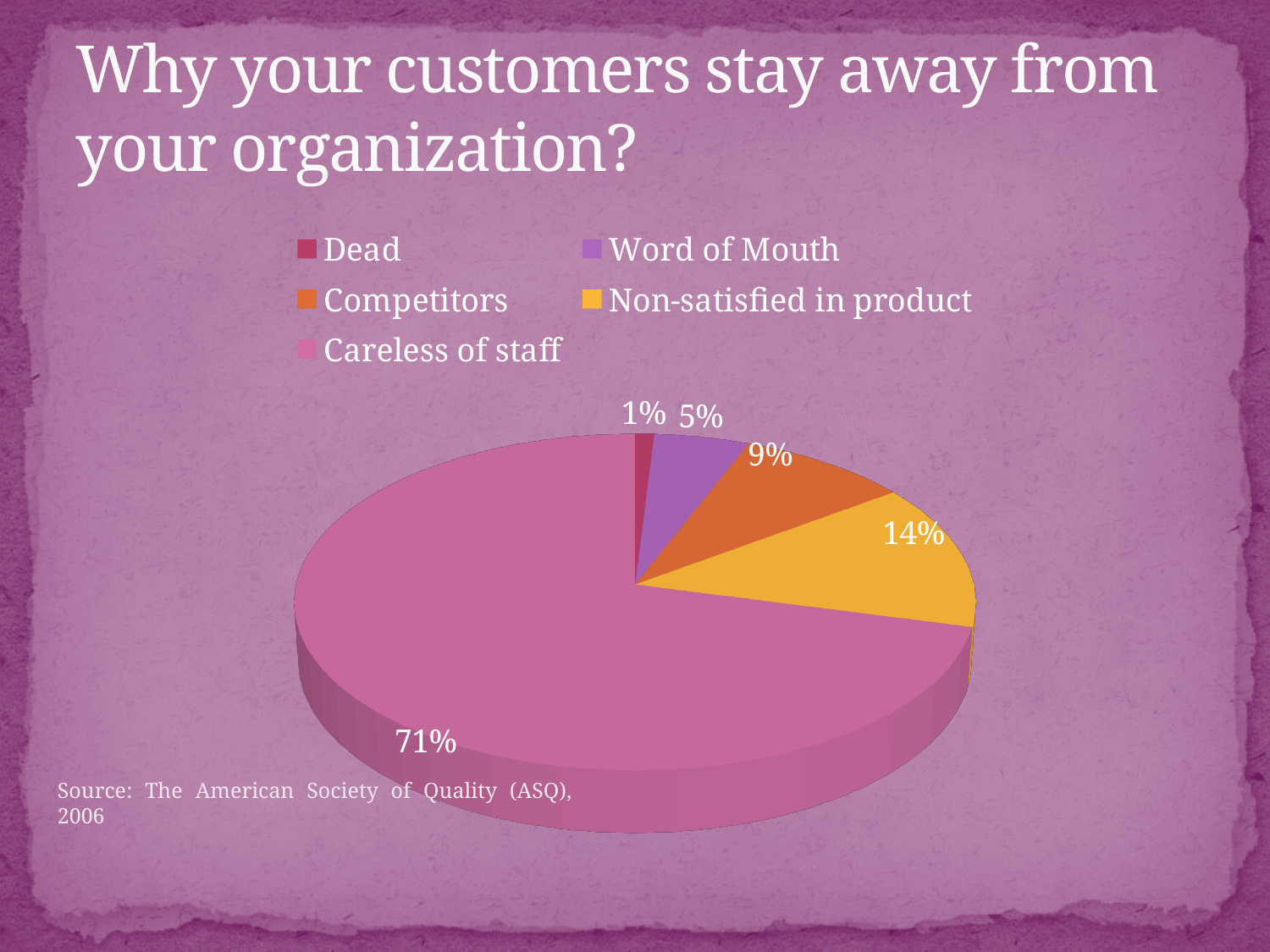
Which category has the largest share of the pie? Careless of staff What percentage of the pie is attributed to Non-satisfied in product? 14% Which category has the smallest share of the pie? Dead Which is larger, the share for Word of Mouth or the share for Competitors? Competitors How many categories does the legend list? 5 What percentage of the pie is attributed to Competitors? 9% What is the title of the slide containing the pie chart? Why your customers stay away from your organization? What percentage of the pie is attributed to Dead? 1% What percentage of the pie is attributed to Word of Mouth? 5% What is the difference in percentage points between Non-satisfied in product and Competitors? 5 What percentage of the pie is attributed to Careless of staff? 71% What type of chart is shown on the slide? Pie chart